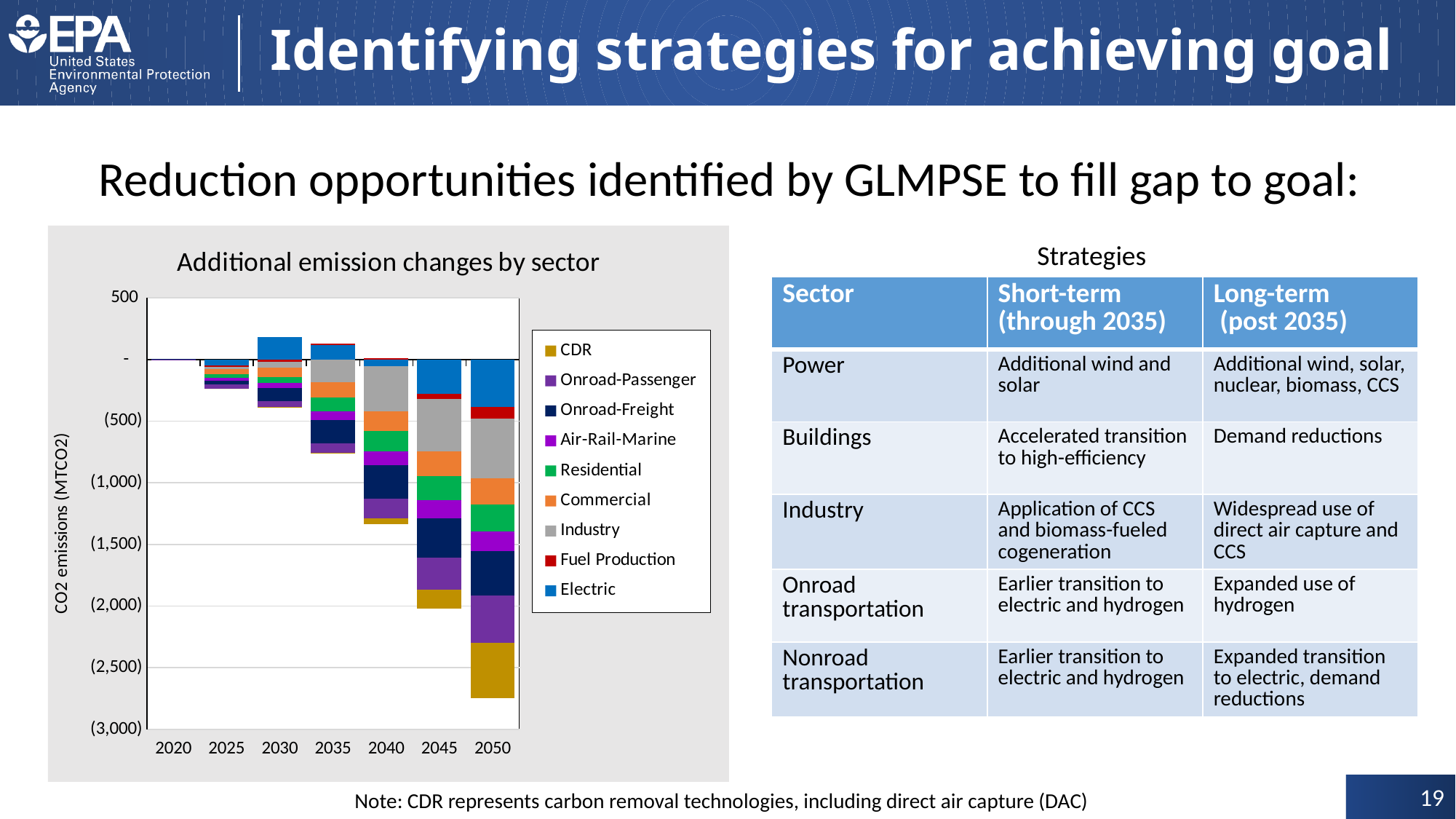
In the 'Additional emission changes by sector' chart, which year has the largest total negative (reduction) stack? 2050 In the 'Additional emission changes by sector' chart, do the negative stacks get larger or smaller from 2025 to 2050? larger In the 'Additional emission changes by sector' chart, which series forms the bottom segment of the 2050 stack? CDR In the 'Additional emission changes by sector' chart, which year has the smallest total emission change? 2020 In the 'Additional emission changes by sector' chart, does the 2040 stack extend below the (1,000) gridline? yes What type of chart is 'Additional emission changes by sector'? stacked bar chart In the 'Additional emission changes by sector' chart, does the 2050 stack extend below the (2,500) gridline? yes How many years are shown on the x axis of the 'Additional emission changes by sector' chart? 7 What is the title of the chart on the slide? Additional emission changes by sector In the 'Additional emission changes by sector' chart, which year has the larger total reduction, 2035 or 2040? 2040 How many series does the legend of the 'Additional emission changes by sector' chart list? 9 What is the y-axis label of the 'Additional emission changes by sector' chart? CO2 emissions (MTCO2)